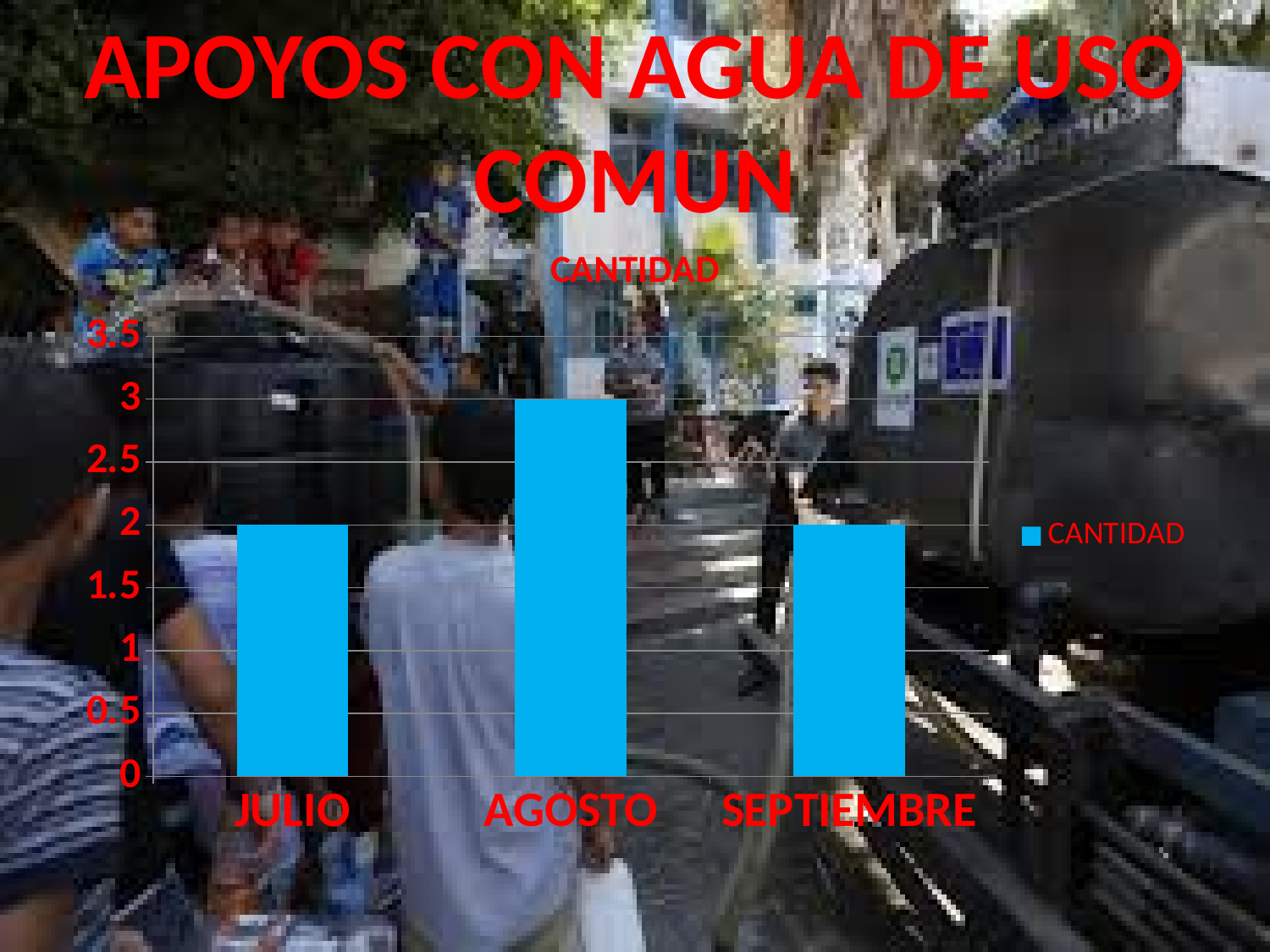
What is the value for SEPTIEMBRE in the CANTIDAD chart? 2 What is the difference between the values for AGOSTO and JULIO? 1 What is the title of the chart? CANTIDAD What is the value for JULIO in the CANTIDAD chart? 2 Which month has the highest value in the CANTIDAD chart? AGOSTO Is the value for AGOSTO greater or less than 2.5? greater How many series does the legend list? 1 What kind of chart is shown on the slide? bar chart How many months are shown on the x axis of the chart? 3 Is the value for JULIO greater or less than 2.5? less What is the value for AGOSTO in the CANTIDAD chart? 3 Which is larger, the value for AGOSTO or the value for SEPTIEMBRE? AGOSTO